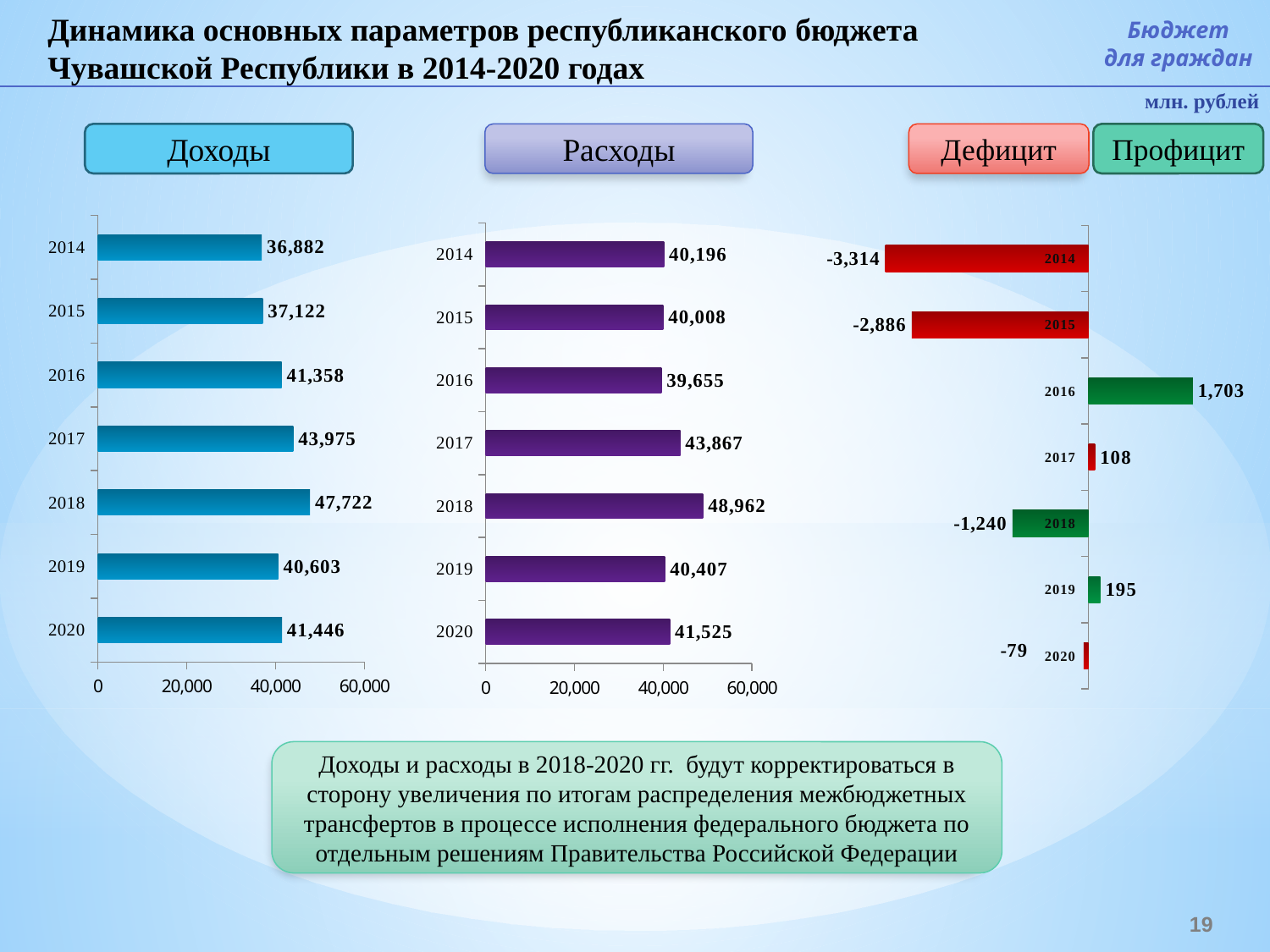
In the Расходы chart, which year has the lowest value? 2016 In the Дефицит/Профицит chart, what is the value for 2014? -3,314 In the Доходы chart, which year has the lowest value? 2014 What type of chart is the Доходы chart? bar chart In the Расходы chart, what is the difference between the values for 2018 and 2017? 5,095 In the Доходы chart, which is larger, the value for 2019 or the value for 2020? 2020 In the Расходы chart, what is the value for 2016? 39,655 In the Доходы chart, what is the value for 2018? 47,722 In the Дефицит/Профицит chart, which year has the largest positive value? 2016 In the Доходы chart, which year has the highest value? 2018 How many years are shown in the Расходы chart? 7 In the Доходы chart, is the value for 2017 greater or less than 40,000? greater